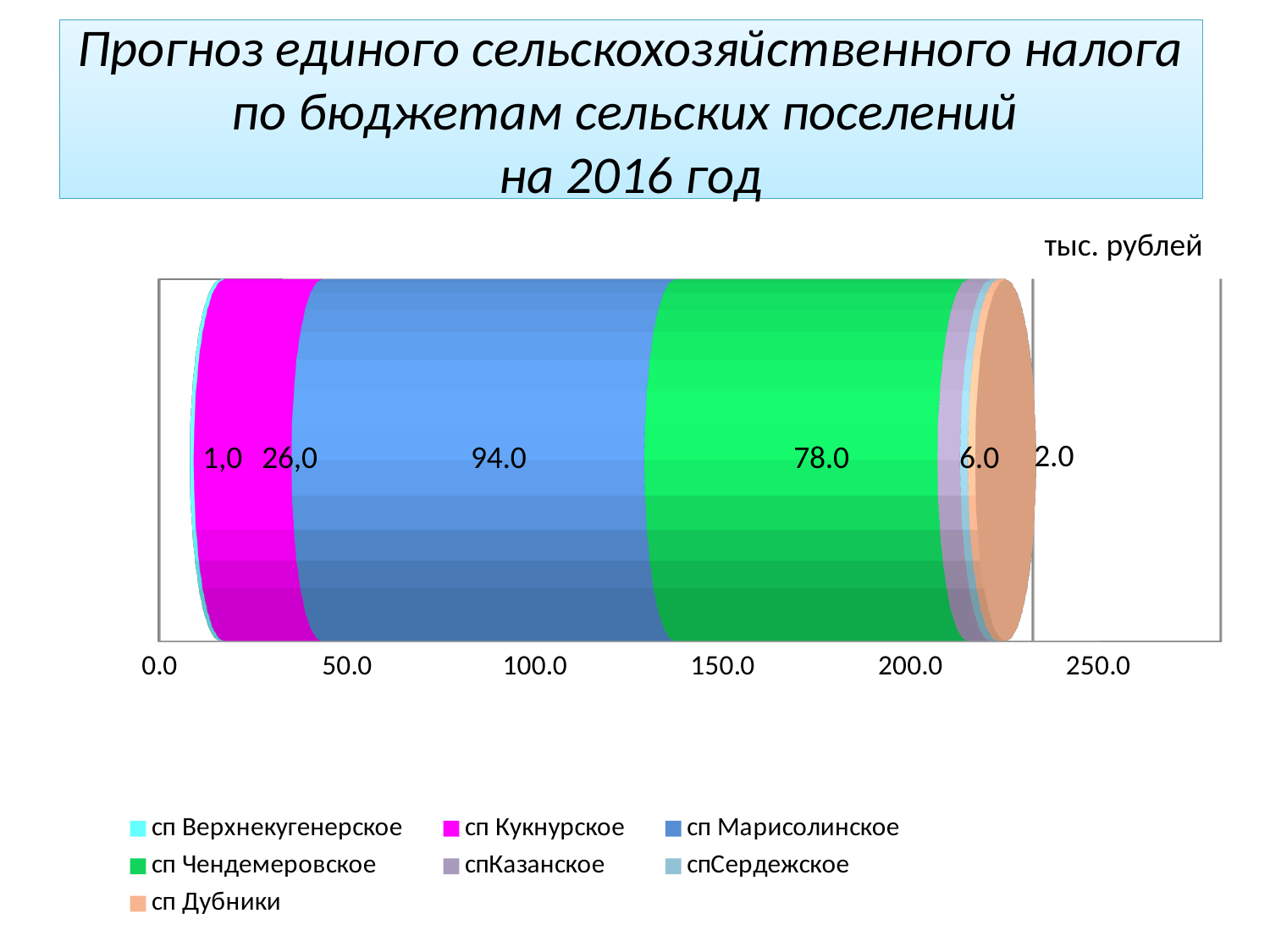
What is the value for сп Кукнурское? 26,0 What unit is indicated above the chart? тыс. рублей What is the value for сп Чендемеровское? 78.0 Which is larger, the value for сп Марисолинское or сп Чендемеровское? сп Марисолинское What kind of chart is shown on the slide? bar chart Is the value for сп Марисолинское greater or less than 50.0? greater How many series does the legend list? 7 Which settlement has the highest forecast value? сп Марисолинское What is the value for сп Марисолинское? 94.0 What is the value for сп Верхнекугенерское? 1,0 What is the difference between the values for сп Марисолинское and сп Чендемеровское? 16.0 What is the difference between the values for сп Кукнурское and сп Верхнекугенерское? 25,0